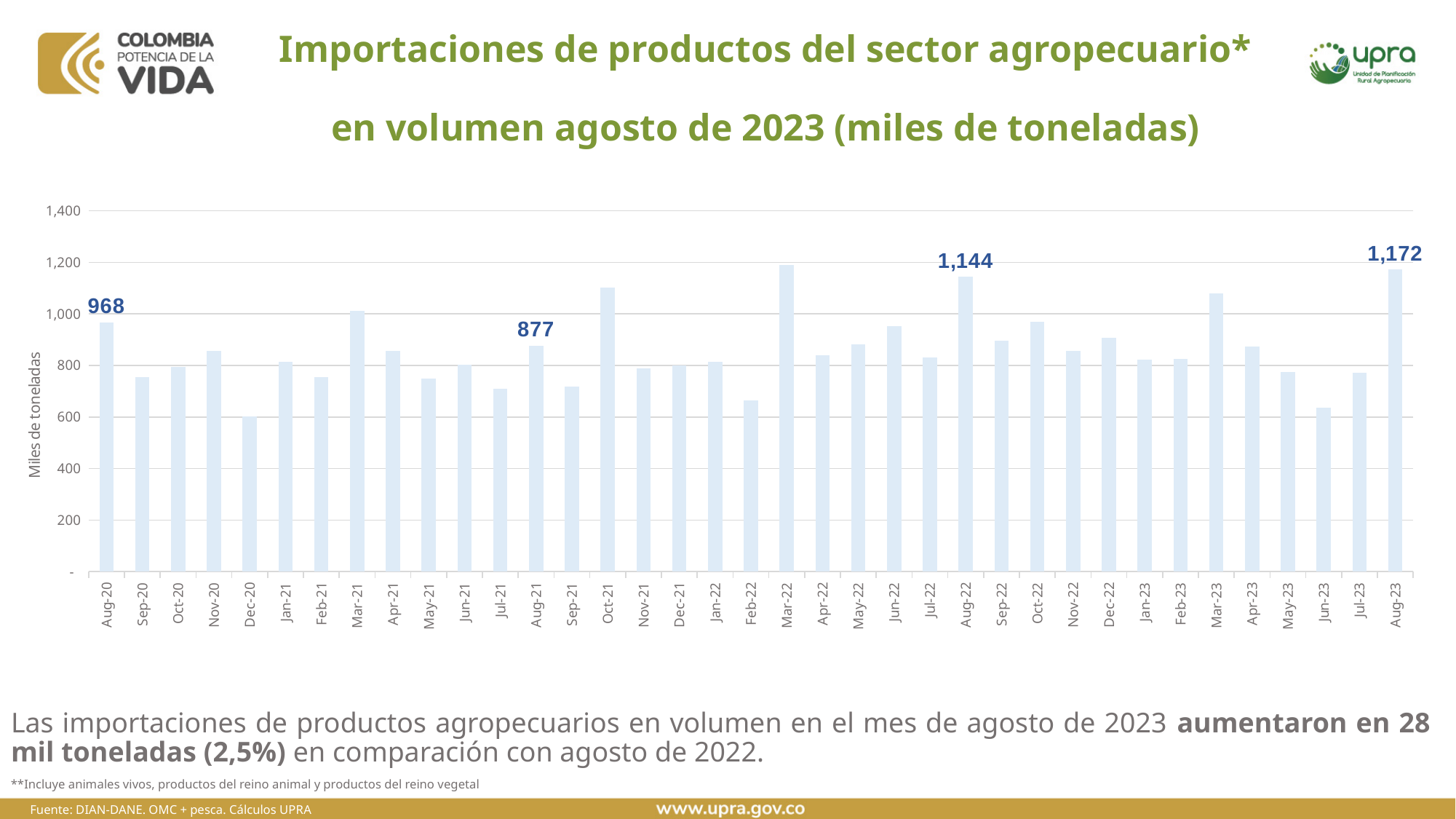
What is the value for Aug-21? 877 What is the value for Aug-22? 1,144 Which is larger, the value for Aug-21 or the value for Aug-20? Aug-20 What is the difference between the values for Aug-22 and Aug-21? 267 How many monthly bars are plotted in the chart? 37 What is the value for Aug-23? 1,172 Which month has the lowest value in the chart? Dec-20 Is the value for Dec-20 greater or less than 800? less What is the value for Aug-20? 968 What kind of chart is shown on the slide? Bar chart What is the difference between the values for Aug-23 and Aug-22? 28 Is the value for Mar-22 greater or less than 1,000? greater